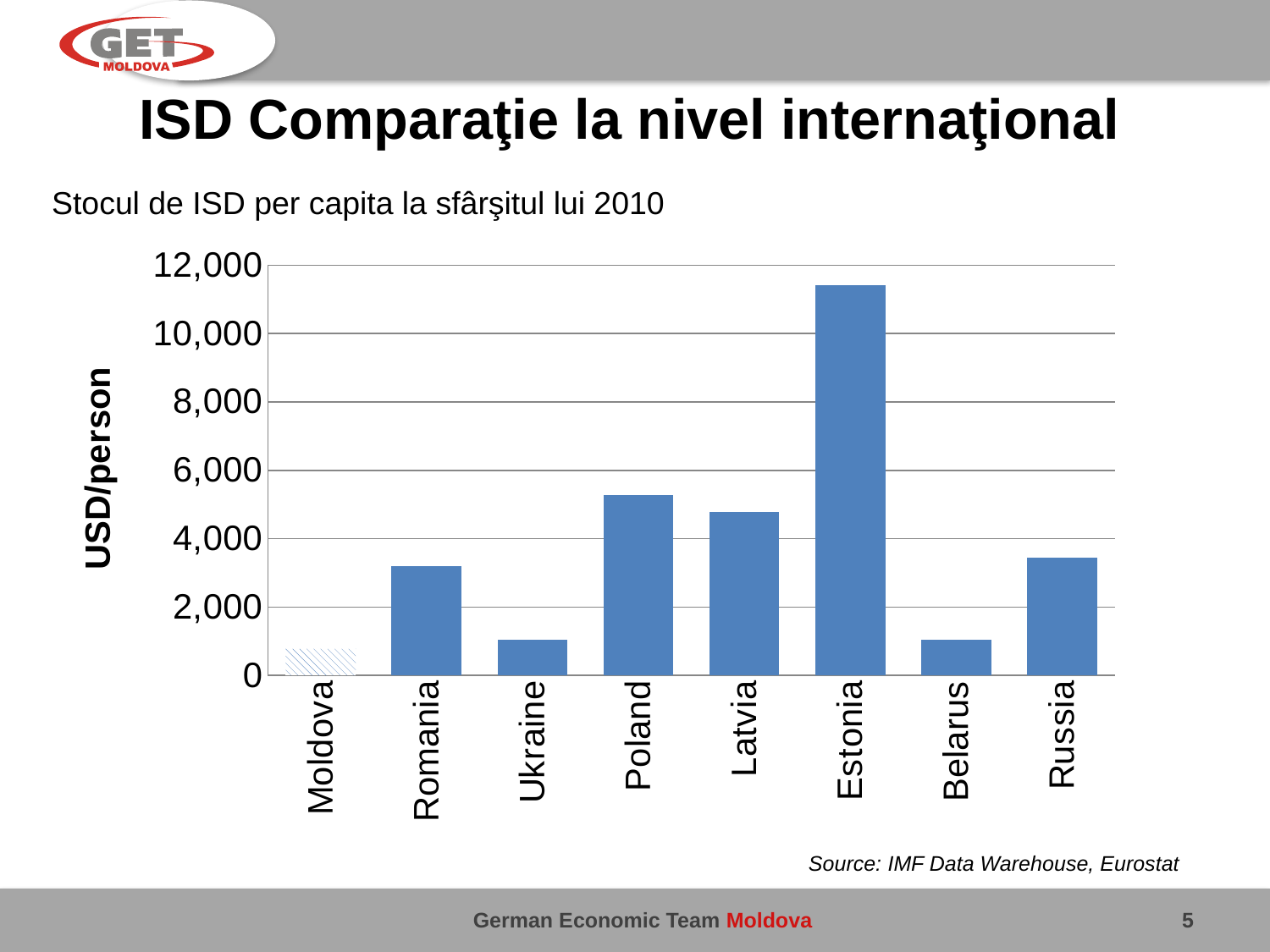
Which country has the lowest FDI stock per capita on the chart? Moldova Which has a larger value, Estonia or Russia? Estonia What kind of chart is shown on the slide? bar chart Is the value for Romania greater or less than 2,000? greater Is the value for Poland greater or less than 4,000? greater Is the value for Russia greater or less than 4,000? less Which has a larger value, Poland or Latvia? Poland How many countries are shown on the chart? 8 Which country has the highest FDI stock per capita on the chart? Estonia What is the label on the vertical axis of the chart? USD/person